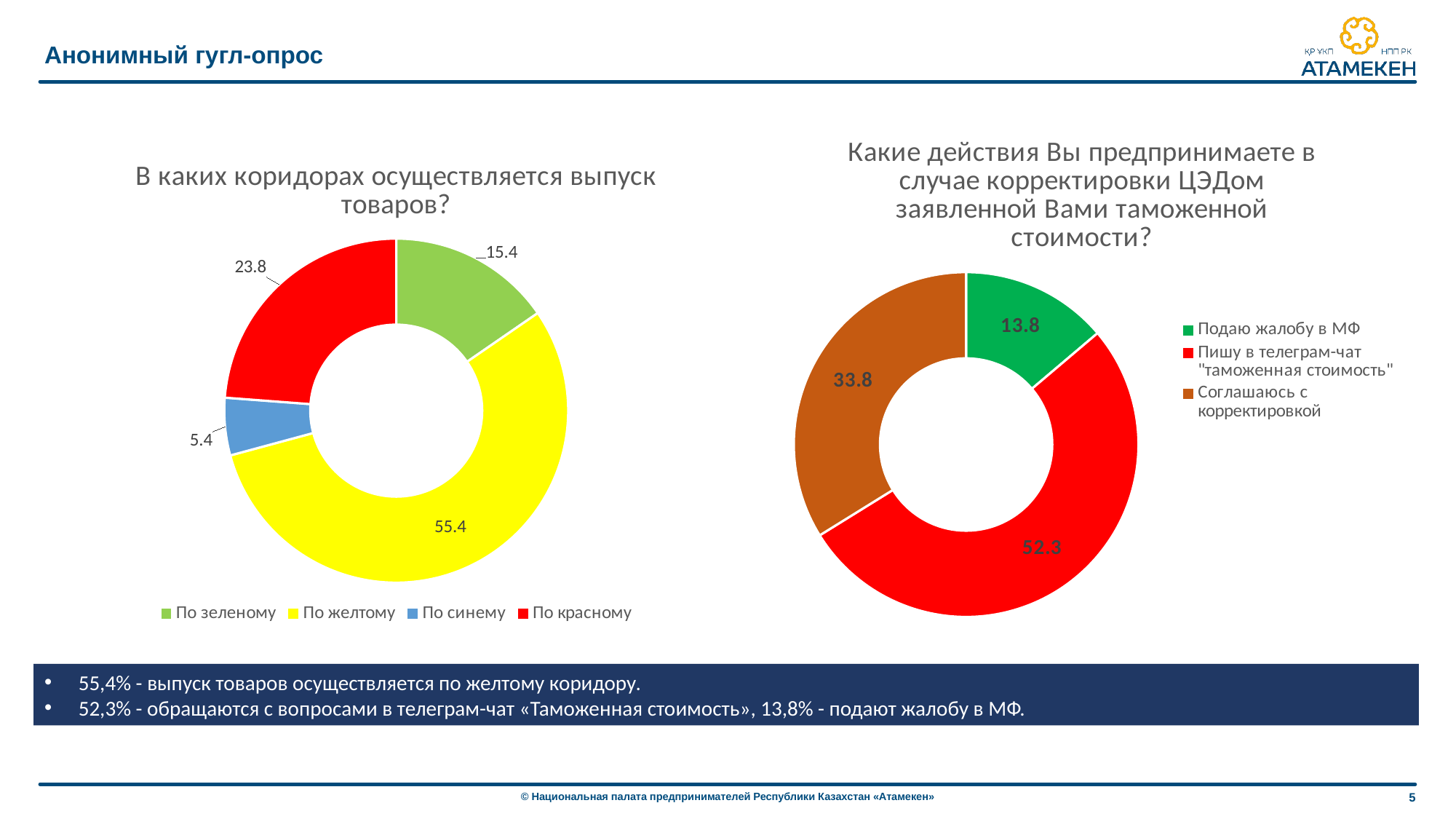
In the right chart, what colour is the segment for Пишу в телеграм-чат "таможенная стоимость"? Red What type of chart is the left chart? Doughnut (pie) chart In the left chart, which category has the largest share? По желтому In the left chart, what is the value for По синему? 5.4 In the left chart, which category has the smallest share? По синему In the right chart, what is the value for Соглашаюсь с корректировкой? 33.8 In the left chart (В каких коридорах осуществляется выпуск товаров?), what is the value for По желтому? 55.4 In the right chart, which category has the largest share? Пишу в телеграм-чат "таможенная стоимость" In the right chart, which is larger: Соглашаюсь с корректировкой or Подаю жалобу в МФ? Соглашаюсь с корректировкой In the right chart (Какие действия Вы предпринимаете...), what is the value for Подаю жалобу в МФ? 13.8 In the left chart, how many categories does the legend list? 4 In the left chart, what is the difference between the values for По красному and По зеленому? 8.4